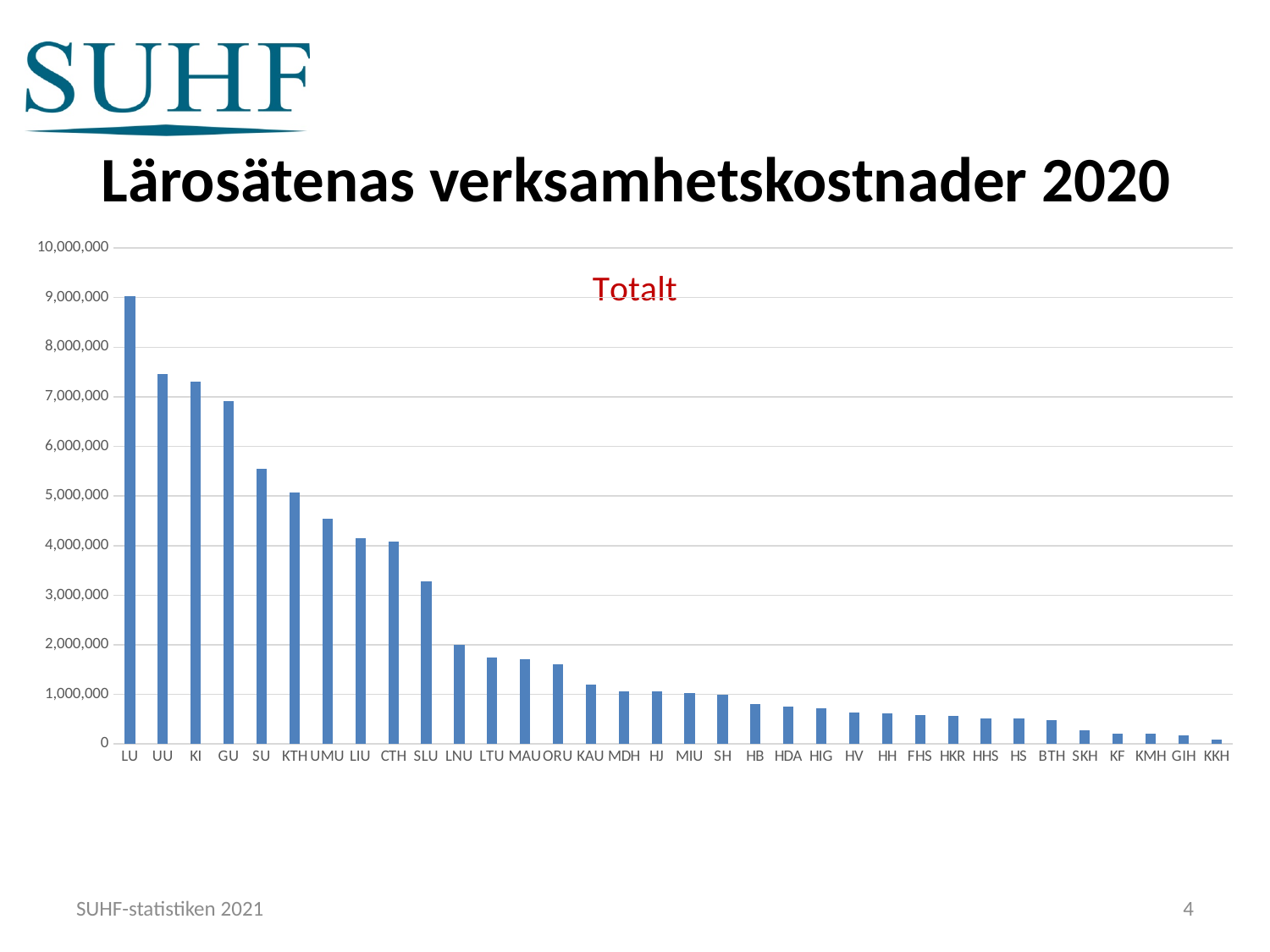
What kind of chart is shown on the slide? bar chart Is the value for LTU greater or less than 2,000,000? less Is the value for SLU greater or less than 3,000,000? greater Is the value for SU greater or less than 5,000,000? greater How many institutions are shown along the x axis? 34 Which institution has the lowest value in the chart? KKH Do the values rise or fall moving from left to right along the x axis? fall Which has the larger value, SU or KTH? SU Which institution has the highest value in the chart? LU What is the title shown inside the chart area? Totalt